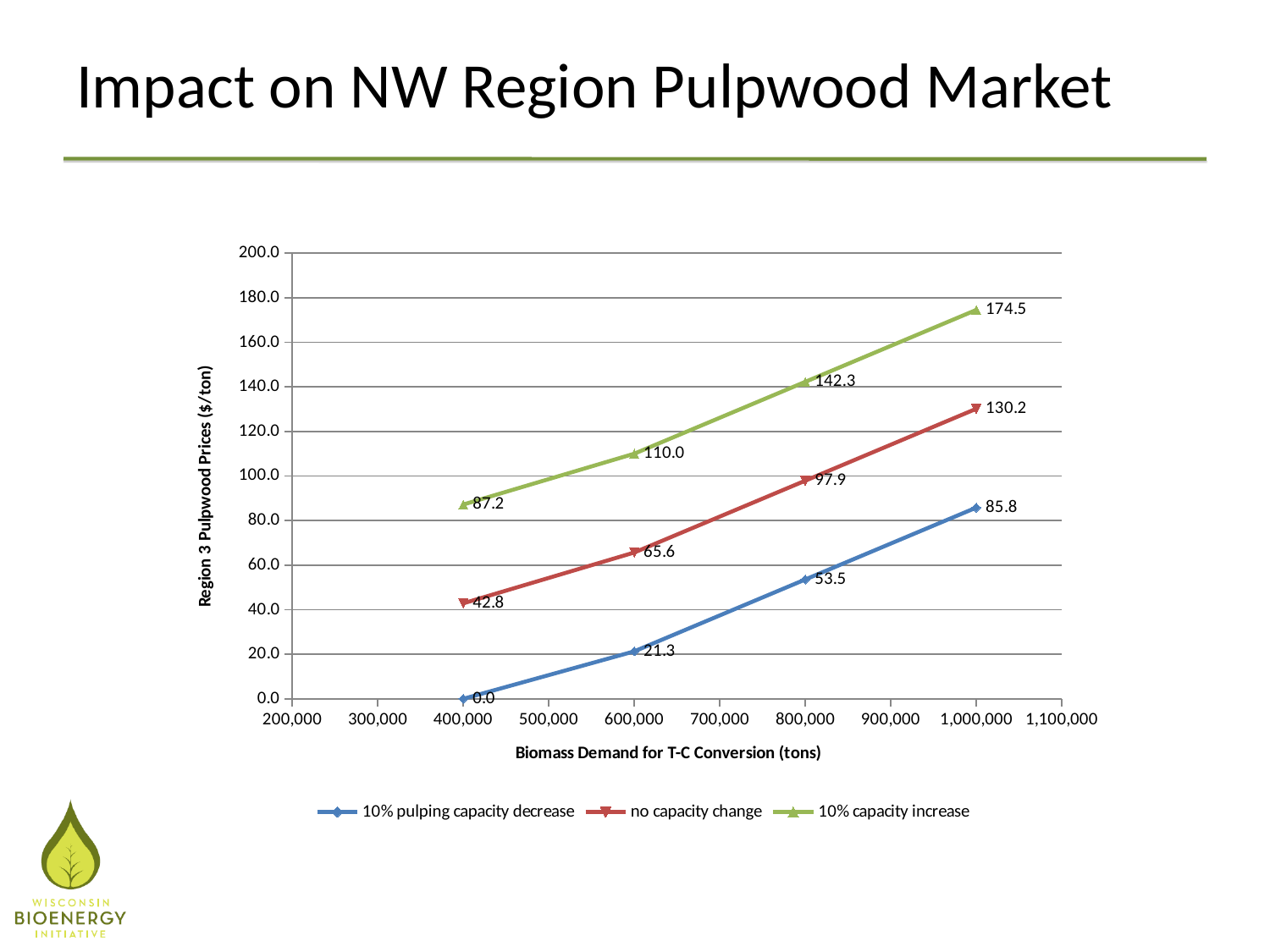
What is the value for the '10% pulping capacity decrease' series at 800,000 tons? 53.5 What is the Region 3 pulpwood price for the '10% capacity increase' series at a biomass demand of 1,000,000 tons? 174.5 What kind of chart is shown on the slide? Line chart Which series has the highest value at 1,000,000 tons of biomass demand? 10% capacity increase Which series has the lowest value at 400,000 tons of biomass demand? 10% pulping capacity decrease How many series does the legend list? 3 Which is larger: the '10% capacity increase' value at 800,000 tons or the 'no capacity change' value at 1,000,000 tons? 10% capacity increase at 800,000 tons How many data points are plotted for each series? 4 What is the label of the y axis? Region 3 Pulpwood Prices ($/ton) What is the difference between the 'no capacity change' value and the '10% pulping capacity decrease' value at 1,000,000 tons? 44.4 What is the value for the 'no capacity change' series at 600,000 tons of biomass demand? 65.6 Do the values for the 'no capacity change' series rise or fall as biomass demand increases? Rise